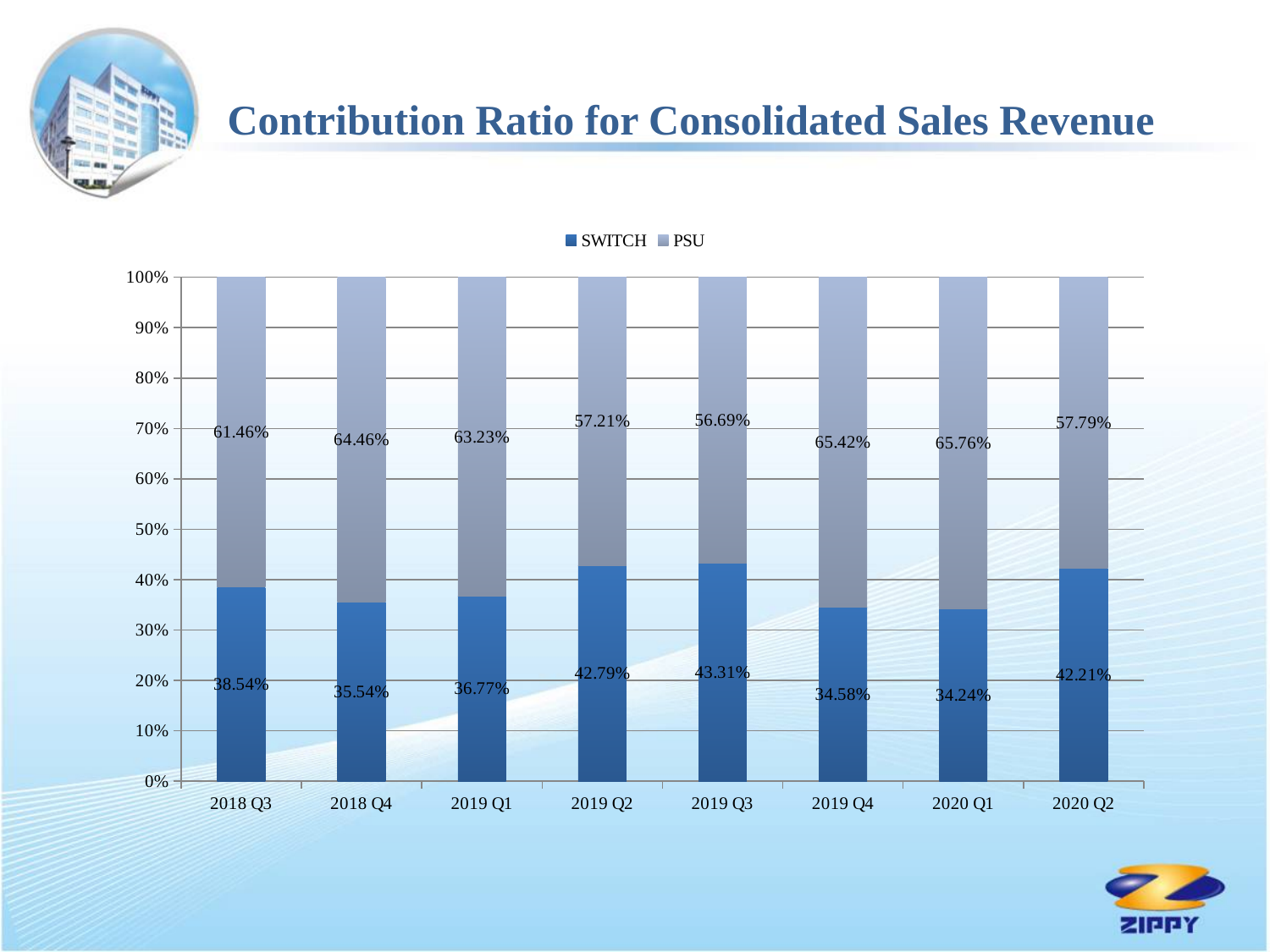
Which quarter has the lowest PSU contribution ratio? 2019 Q3 What is the difference between the PSU ratio and the SWITCH ratio in 2018 Q3? 22.92% What is the SWITCH contribution ratio for 2019 Q3? 43.31% How many series does the legend list? 2 What kind of chart is shown on the slide? Stacked bar chart Is the SWITCH contribution ratio larger in 2019 Q2 or in 2019 Q4? 2019 Q2 How many quarters are shown on the x axis? 8 What is the title of the chart on the slide? Contribution Ratio for Consolidated Sales Revenue Which quarter has the lowest SWITCH contribution ratio? 2020 Q1 What is the SWITCH contribution ratio for 2018 Q4? 35.54% What is the PSU contribution ratio for 2020 Q1? 65.76% Which quarter has the highest SWITCH contribution ratio? 2019 Q3